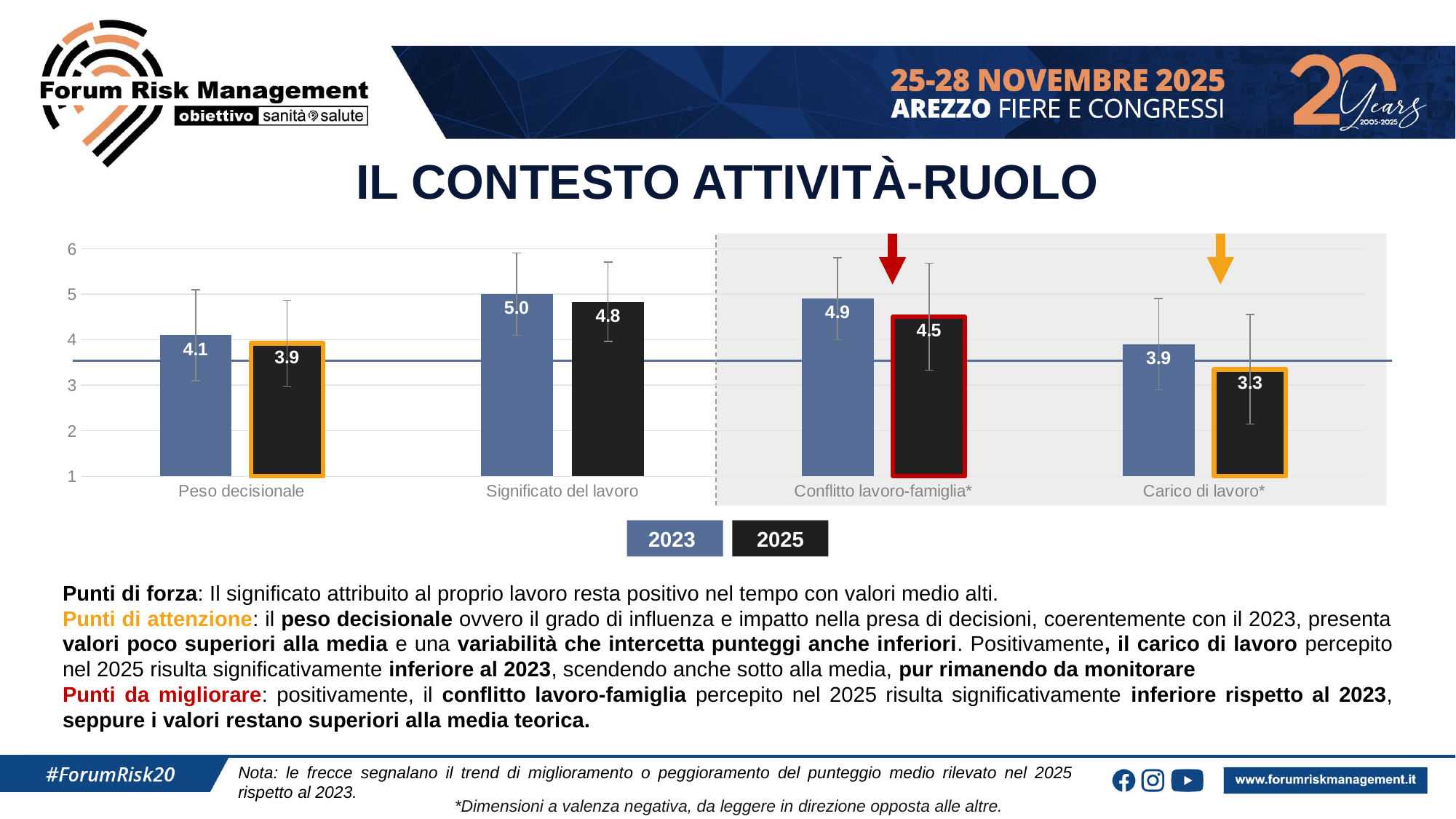
What is the difference between the 2023 and 2025 values for Carico di lavoro*? 0.6 How many categories are shown on the x axis of the chart? 4 What is the 2025 value for Carico di lavoro*? 3.3 Which category has the lowest 2025 value? Carico di lavoro* What is the 2023 value for Significato del lavoro? 5.0 Which is larger for Significato del lavoro, the 2023 value or the 2025 value? 2023 What is the 2023 value for Peso decisionale? 4.1 What kind of chart is shown on the slide? Bar chart What is the difference between the 2023 and 2025 values for Conflitto lavoro-famiglia*? 0.4 How many series does the legend list? 2 Which category has the highest 2023 value? Significato del lavoro What is the 2025 value for Conflitto lavoro-famiglia*? 4.5